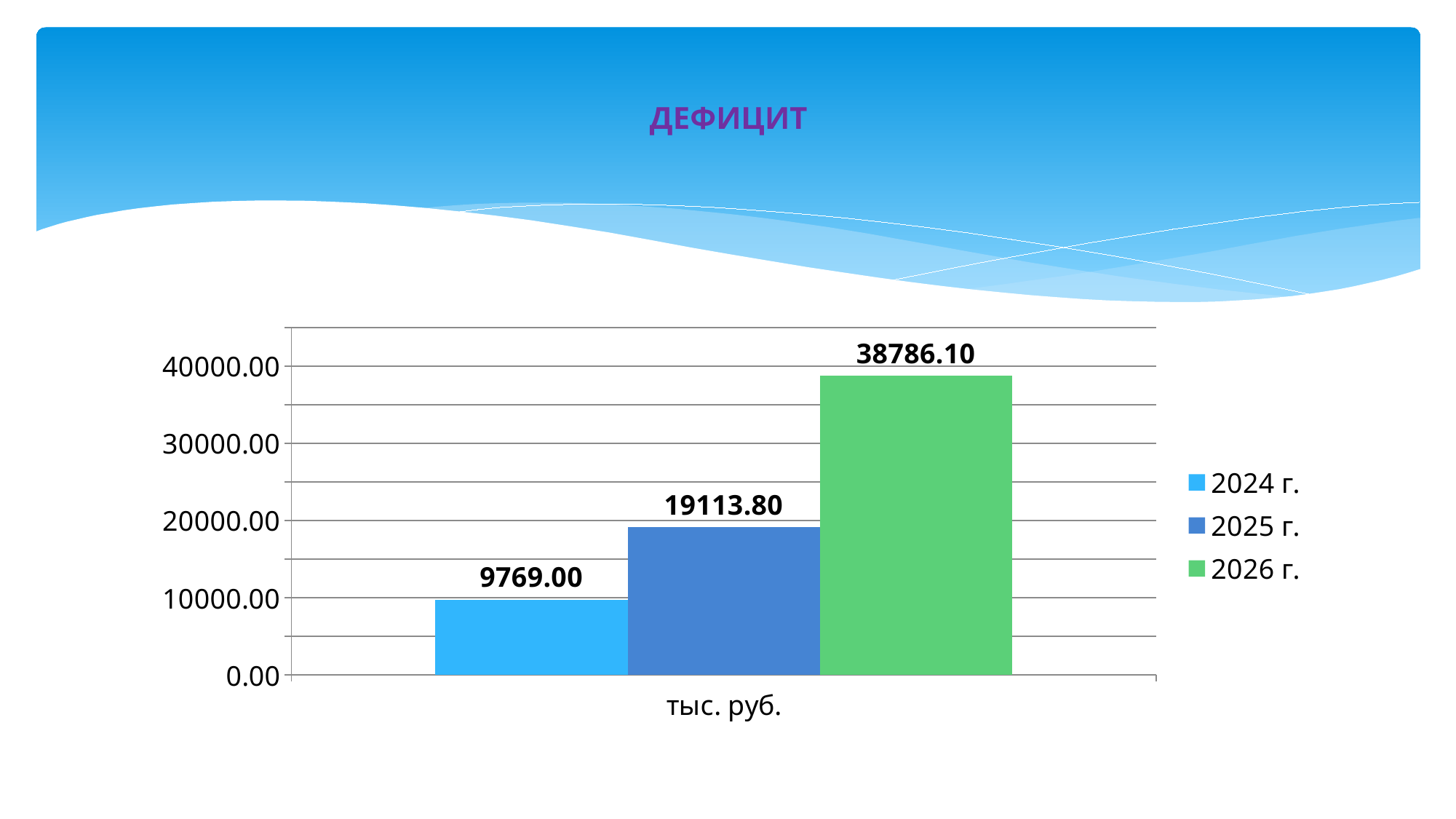
Which is larger, the value for 2024 г. or the value for 2025 г.? 2025 г. What is the value for 2026 г.? 38786.10 Is the value for 2026 г. greater or less than 30000.00? greater How many series does the legend list? 3 Which year has the lowest value? 2024 г. What is the difference between the values for 2026 г. and 2025 г.? 19672.30 What is the title of the slide above the chart? ДЕФИЦИТ Which year has the highest value? 2026 г. What is the value for 2025 г.? 19113.80 What is the difference between the values for 2025 г. and 2024 г.? 9344.80 What kind of chart is shown on the slide? bar chart What is the value for 2024 г.? 9769.00